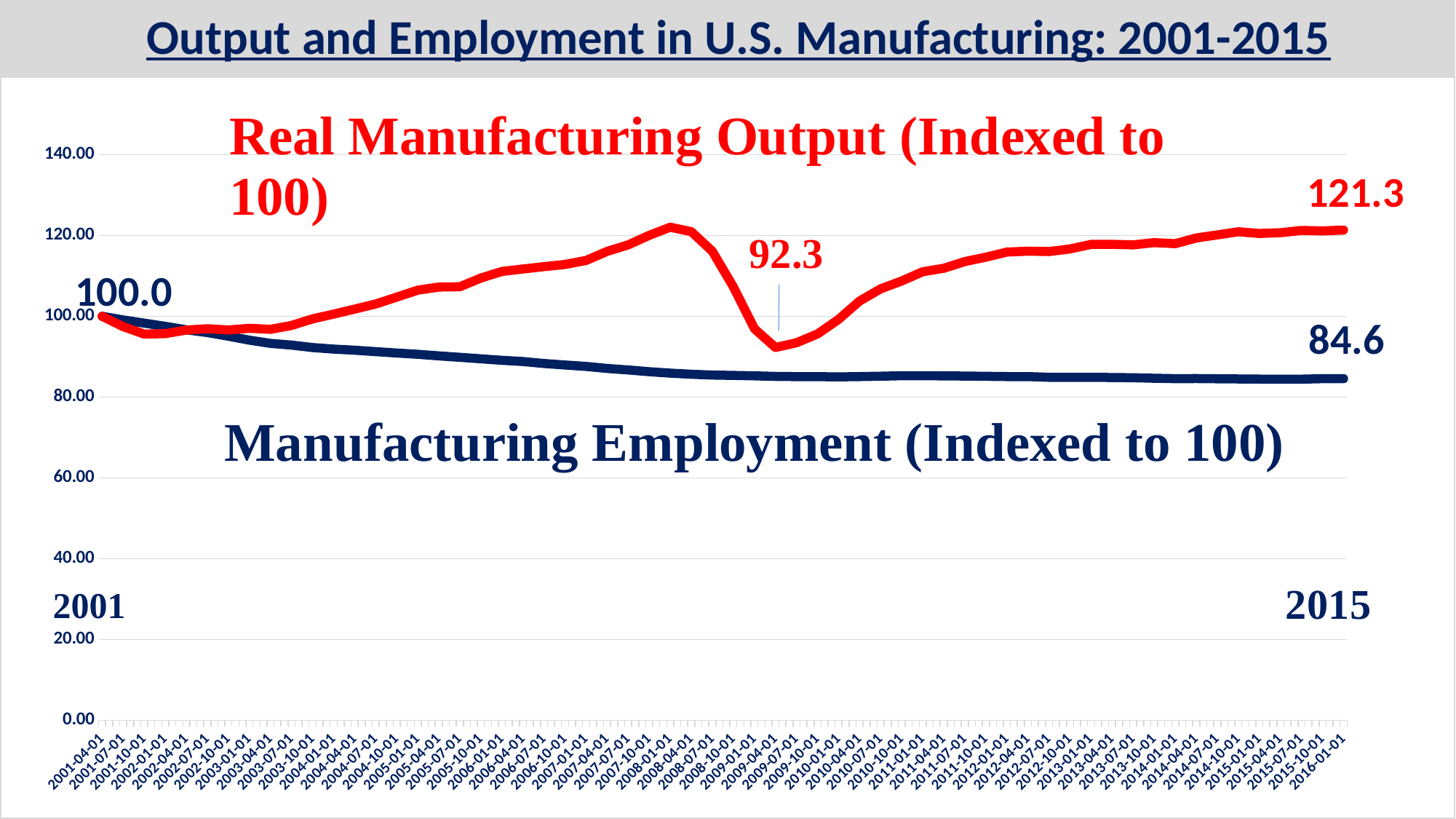
Does the Manufacturing Employment line generally rise or fall from 2001 to 2015? fall What is the difference between the final labeled values of Real Manufacturing Output (121.3) and Manufacturing Employment (84.6)? 36.7 What is the final labeled value of Real Manufacturing Output (Indexed to 100) at the right end of the chart? 121.3 Is the value of Manufacturing Employment at 2008-01-01 greater or less than 100? less By how much did Real Manufacturing Output rise from its starting value of 100.0 to its final value of 121.3? 21.3 What kind of chart is shown on the slide? line chart What colour is the Real Manufacturing Output line? red By how much did Manufacturing Employment fall from its starting value of 100.0 to its final value of 84.6? 15.4 What is the labeled value at the low point of the Real Manufacturing Output line around 2009? 92.3 At the end of the chart, which series is higher: Real Manufacturing Output or Manufacturing Employment? Real Manufacturing Output What is the final labeled value of Manufacturing Employment (Indexed to 100) at the right end of the chart? 84.6 What labeled value do both series start at in 2001? 100.0